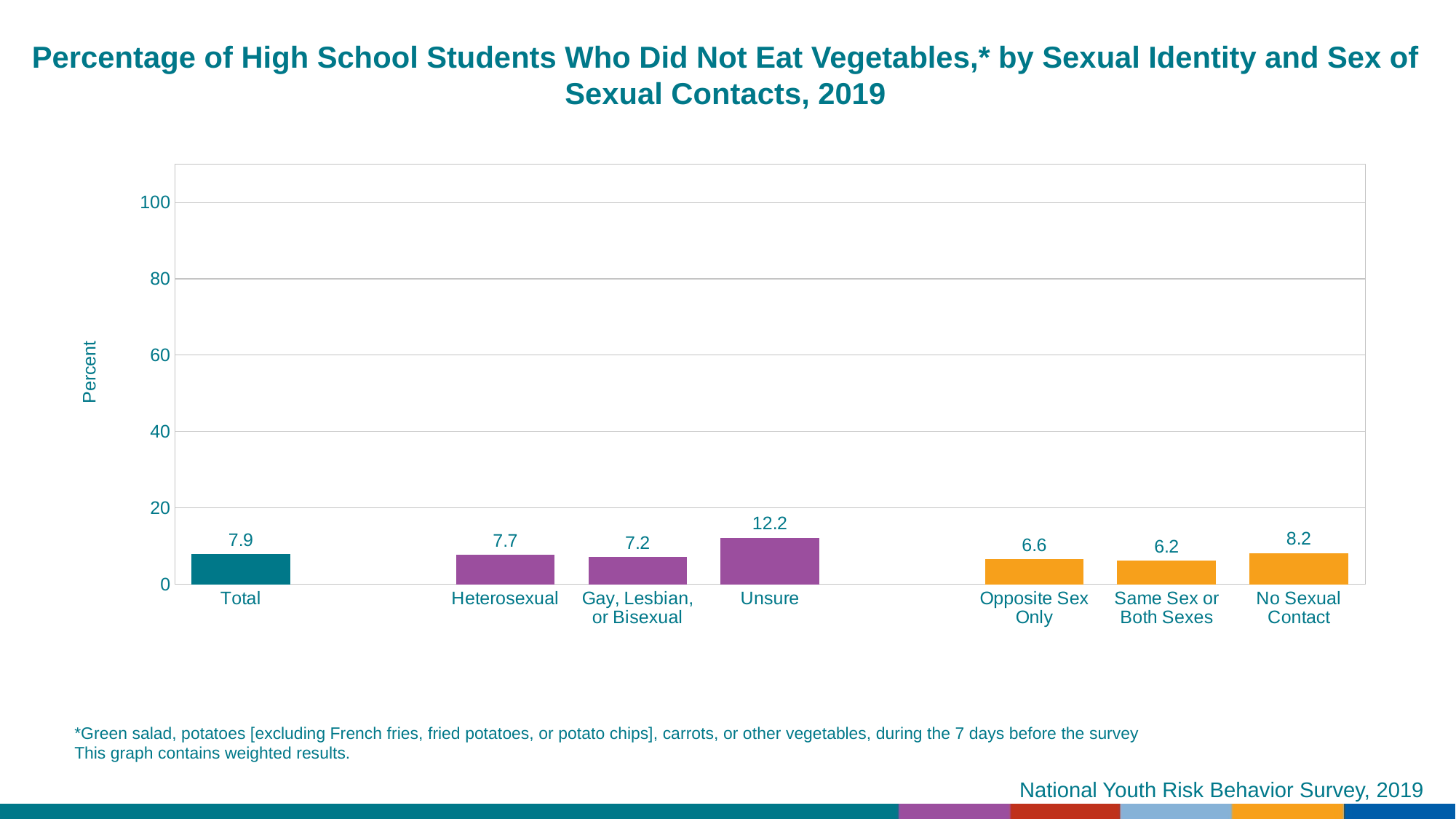
What is the value for Unsure? 12.2 How many categories are shown on the x axis? 7 What is the label of the y axis? Percent Which is larger, the value for Opposite Sex Only or the value for No Sexual Contact? No Sexual Contact What is the value for Total? 7.9 Is the value for Unsure greater or less than 20? less What is the difference between the values for Unsure and Heterosexual? 4.5 Which category has the lowest value? Same Sex or Both Sexes What kind of chart is this? bar chart Which category has the highest value? Unsure What is the value for No Sexual Contact? 8.2 What is the value for Same Sex or Both Sexes? 6.2